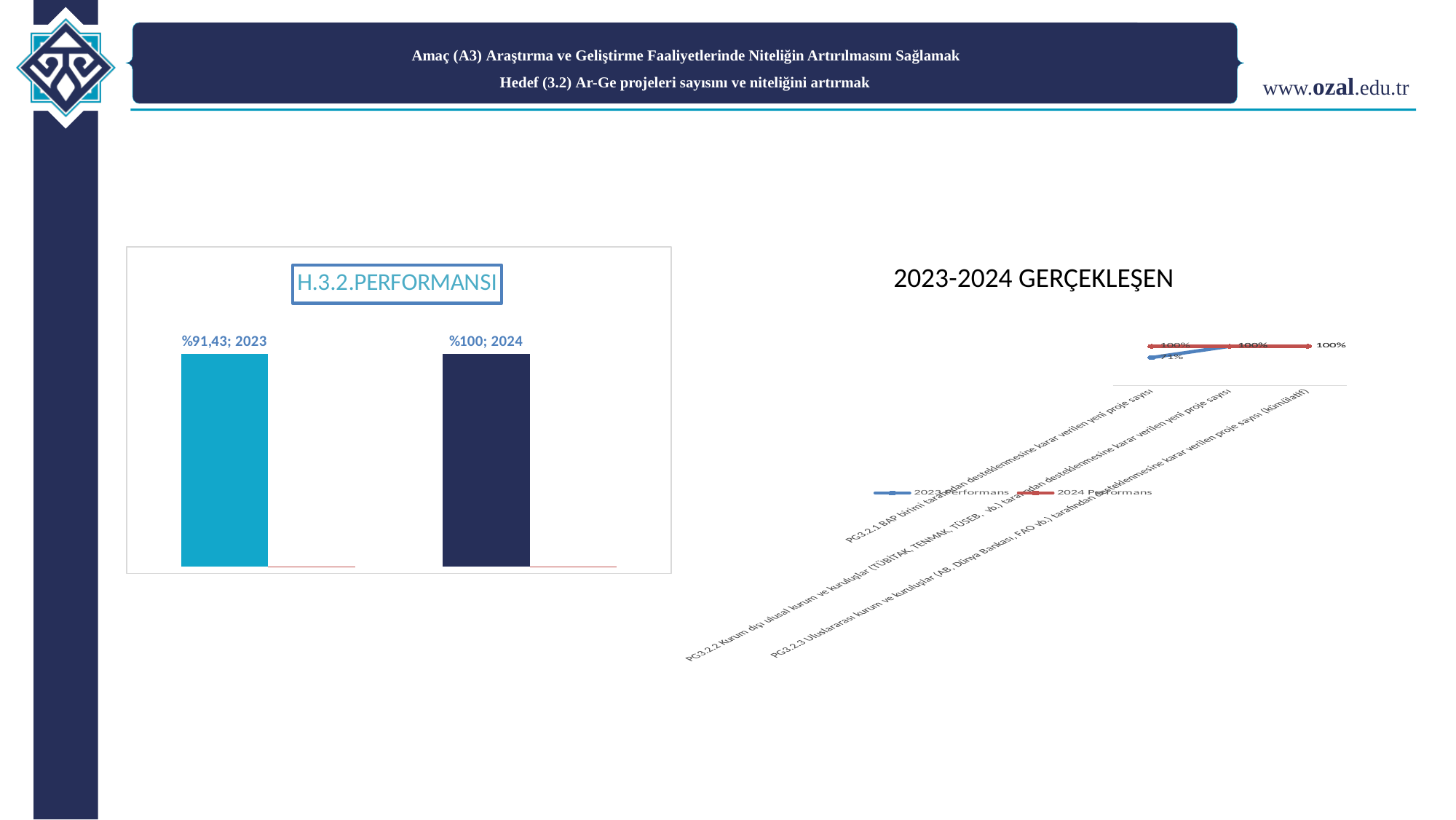
In the H.3.2.PERFORMANSI chart, what is the value for 2024? %100 In the H.3.2.PERFORMANSI chart, do the values rise or fall from 2023 to 2024? rise In the H.3.2.PERFORMANSI chart, which year has the lower value? 2023 What kind of chart is the H.3.2.PERFORMANSI chart? bar chart In the H.3.2.PERFORMANSI chart, which year has the higher value? 2024 In the H.3.2.PERFORMANSI chart, what is the difference between the 2024 and 2023 values? %8,57 In the H.3.2.PERFORMANSI chart, what is the value for 2023? %91,43 How many bars are shown in the H.3.2.PERFORMANSI chart? 2 What is the title of the chart on the left side of the slide? H.3.2.PERFORMANSI In the H.3.2.PERFORMANSI chart, is the value for 2023 larger or smaller than the value for 2024? smaller How many series does the legend of the 2023-2024 GERÇEKLEŞEN chart list? 2 What kind of chart is the 2023-2024 GERÇEKLEŞEN chart? line chart